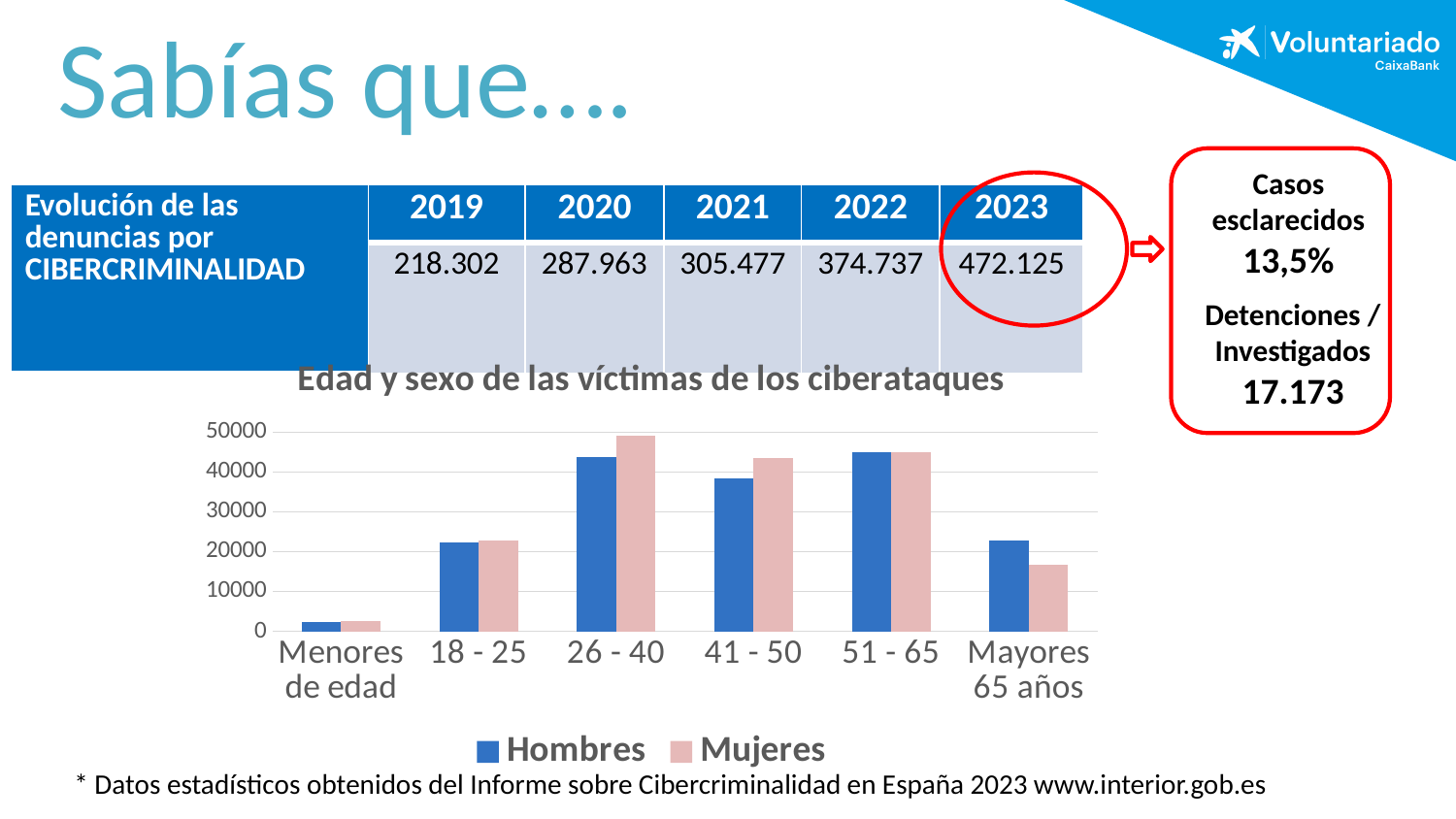
In the chart "Edad y sexo de las víctimas de los ciberataques", which is larger for the 41 - 50 category, Hombres or Mujeres? Mujeres How many series does the legend of the chart "Edad y sexo de las víctimas de los ciberataques" list? 2 What are the two legend entries of the chart "Edad y sexo de las víctimas de los ciberataques"? Hombres and Mujeres In the chart "Edad y sexo de las víctimas de los ciberataques", is the value for Hombres in the Menores de edad category greater or less than 10000? less In the chart "Edad y sexo de las víctimas de los ciberataques", which age category has the highest value for Mujeres? 26 - 40 In the chart "Edad y sexo de las víctimas de los ciberataques", is the value for Mujeres in the 26 - 40 category greater or less than 40000? greater How many age categories are shown on the x axis of the chart "Edad y sexo de las víctimas de los ciberataques"? 6 In the chart "Edad y sexo de las víctimas de los ciberataques", is the value for Mujeres in the Mayores 65 años category greater or less than 20000? less In the chart "Edad y sexo de las víctimas de los ciberataques", which is larger for the Mayores 65 años category, Hombres or Mujeres? Hombres What kind of chart is "Edad y sexo de las víctimas de los ciberataques"? bar chart In the chart "Edad y sexo de las víctimas de los ciberataques", which age category has the lowest value for Hombres? Menores de edad